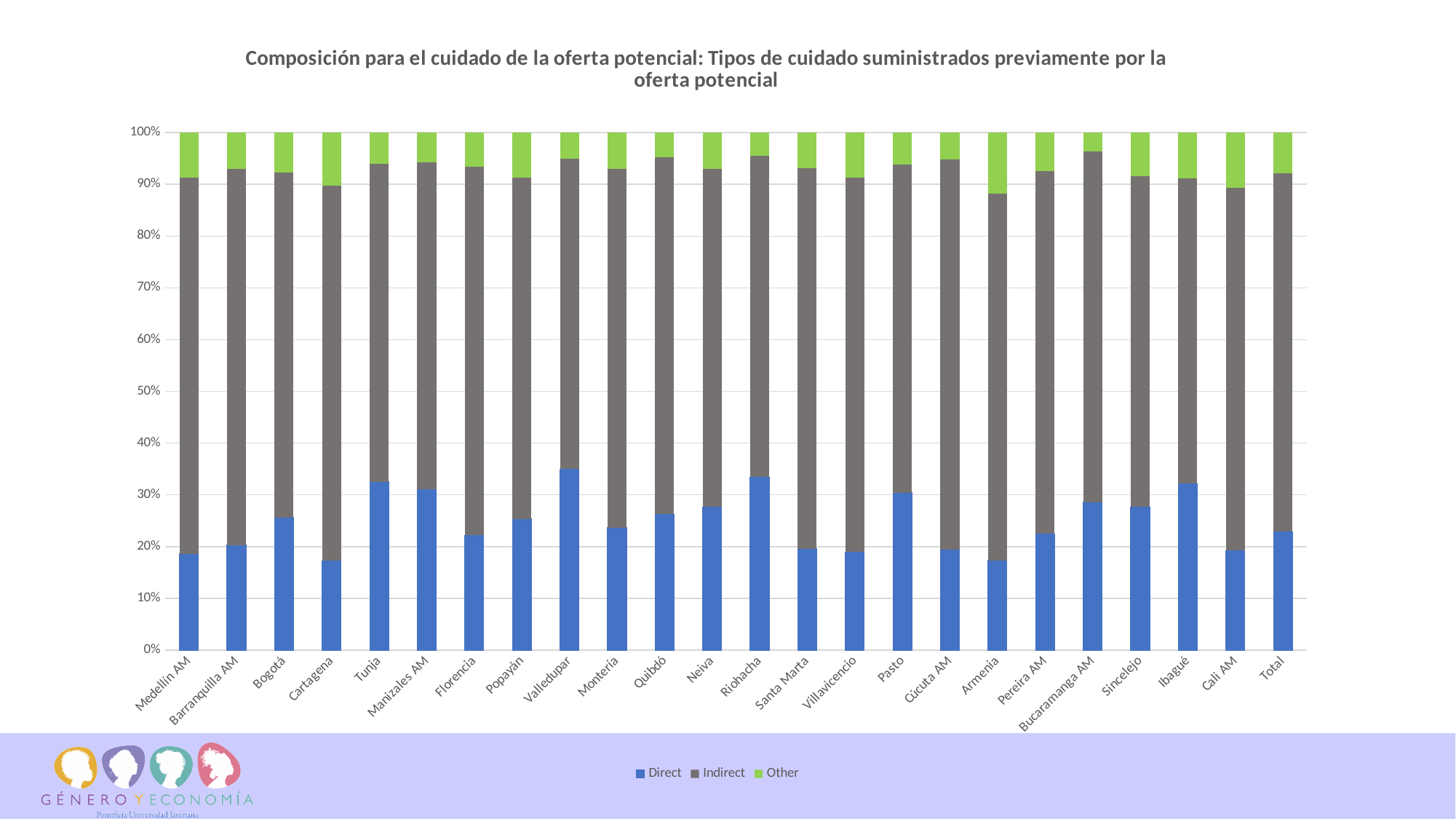
Is the Direct value for Valledupar greater or less than 30%? greater Which series is shown in green in the chart? Other Is the Direct value for Cartagena greater or less than 20%? less Is the Direct value for Medellín AM greater or less than 20%? less What kind of chart is shown on the slide? Stacked bar chart Which has a larger Direct share, Valledupar or Cartagena? Valledupar Which category has the largest Other share? Armenia What is the total height of the stacked bar for Total? 100% How many series does the legend list? 3 How many categories are shown along the x axis of the chart? 24 What are the series names listed in the legend? Direct, Indirect, Other